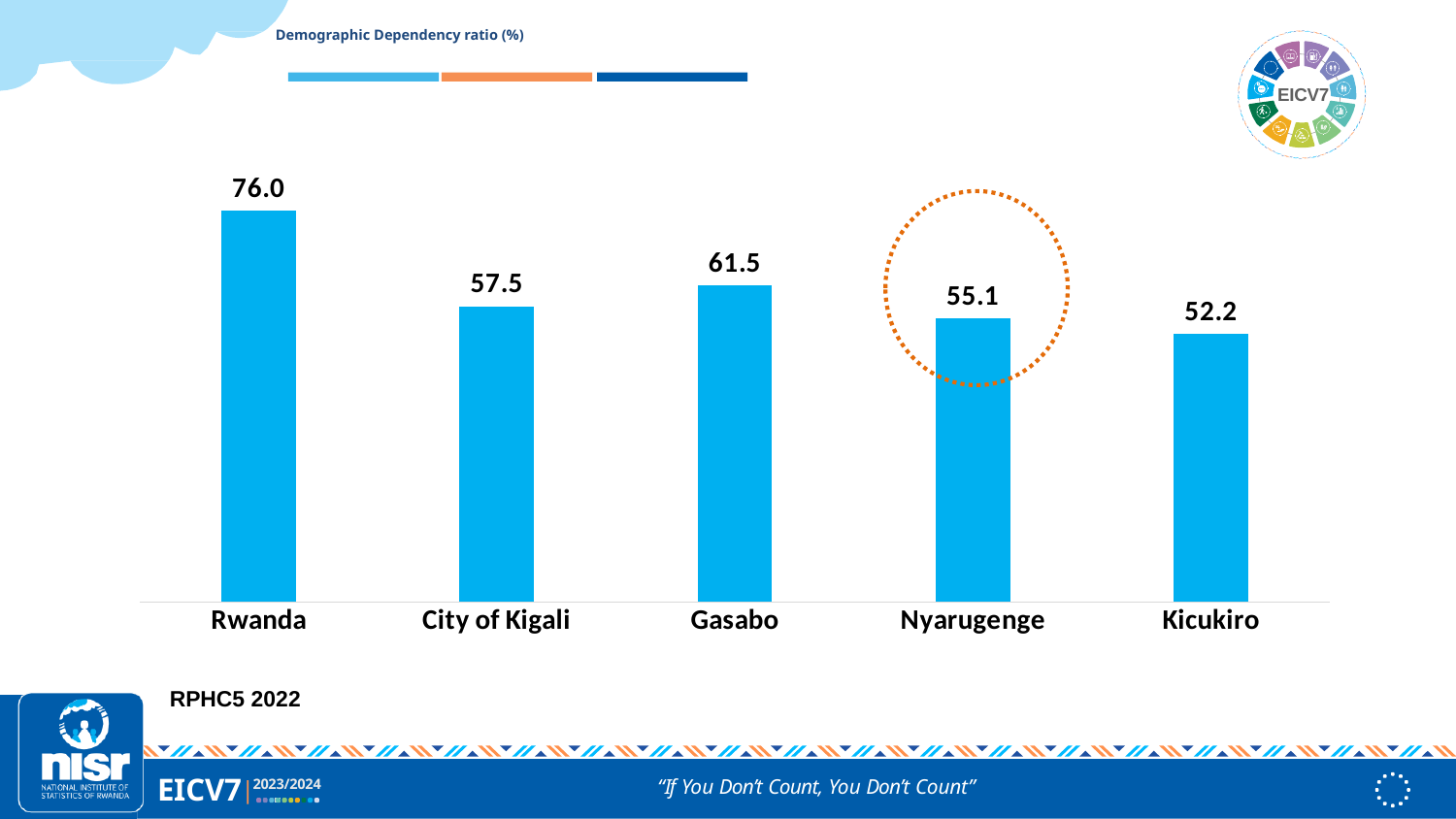
What is the demographic dependency ratio for Rwanda? 76.0 What is the demographic dependency ratio for City of Kigali? 57.5 Which has a higher demographic dependency ratio, Gasabo or Nyarugenge? Gasabo How many categories are shown in the chart? 5 What kind of chart is shown on the slide? Bar chart What is the difference between the demographic dependency ratio for Rwanda and for City of Kigali? 18.5 What is the demographic dependency ratio for Gasabo? 61.5 Which category has the highest demographic dependency ratio? Rwanda Which category has the lowest demographic dependency ratio? Kicukiro What is the difference between the demographic dependency ratio for Gasabo and for Kicukiro? 9.3 What is the demographic dependency ratio for Nyarugenge? 55.1 Which category's bar is highlighted with a dotted orange circle? Nyarugenge